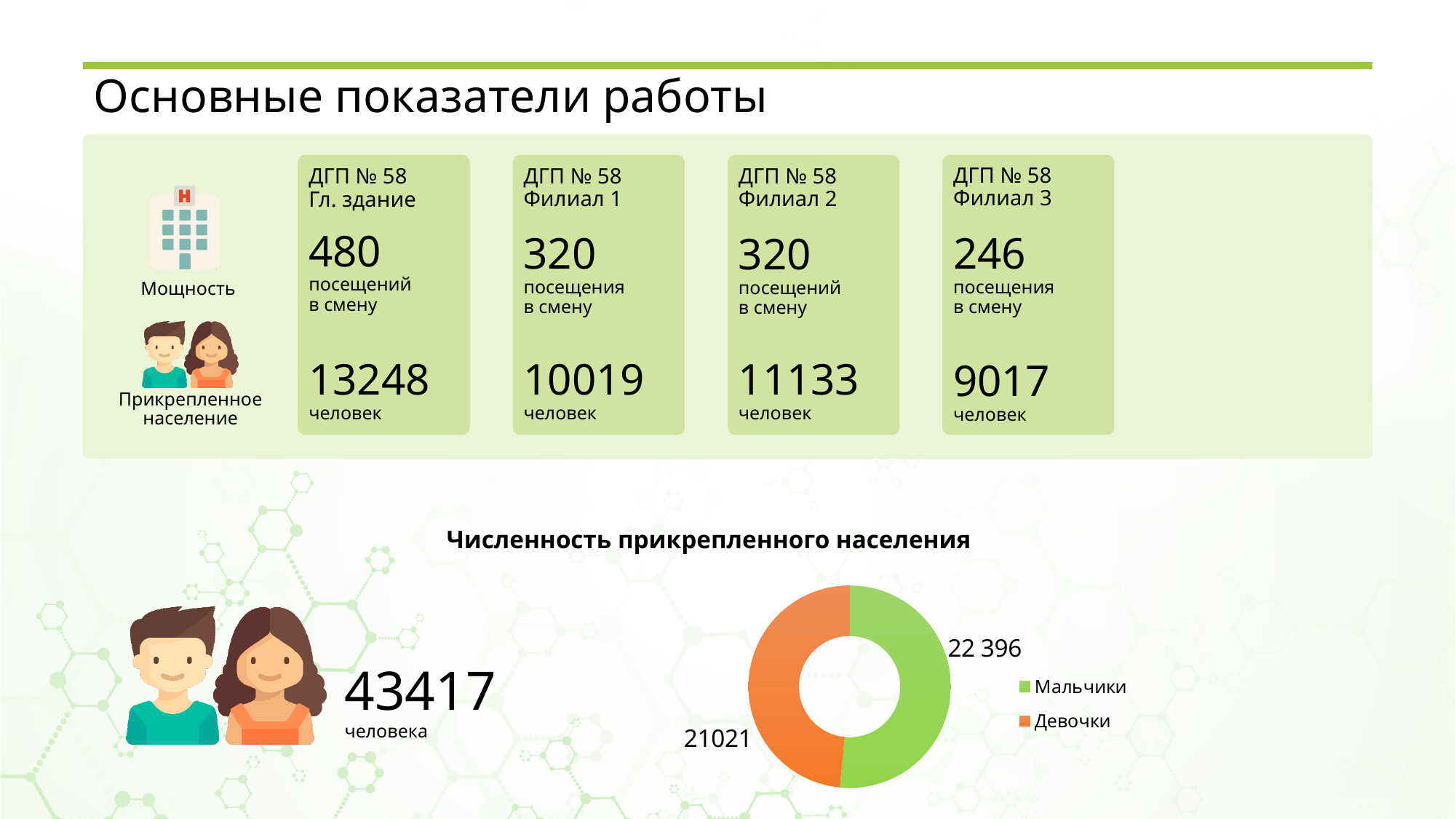
In the chart 'Численность прикрепленного населения', which is larger: Мальчики or Девочки? Мальчики What is the value for Мальчики in the chart 'Численность прикрепленного населения'? 22 396 How many entries does the legend of the chart 'Численность прикрепленного населения' list? 2 How many categories does the chart 'Численность прикрепленного населения' show? 2 What colour is the Девочки slice in the chart 'Численность прикрепленного населения'? orange In the chart 'Численность прикрепленного населения', what is the difference between the values for Мальчики and Девочки? 1375 What kind of chart is 'Численность прикрепленного населения'? doughnut chart Which category has the largest slice in the chart 'Численность прикрепленного населения'? Мальчики Which category has the smallest slice in the chart 'Численность прикрепленного населения'? Девочки What is the total of the two slices in the chart 'Численность прикрепленного населения'? 43417 What is the title of the pie chart on the slide? Численность прикрепленного населения What is the value for Девочки in the chart 'Численность прикрепленного населения'? 21021